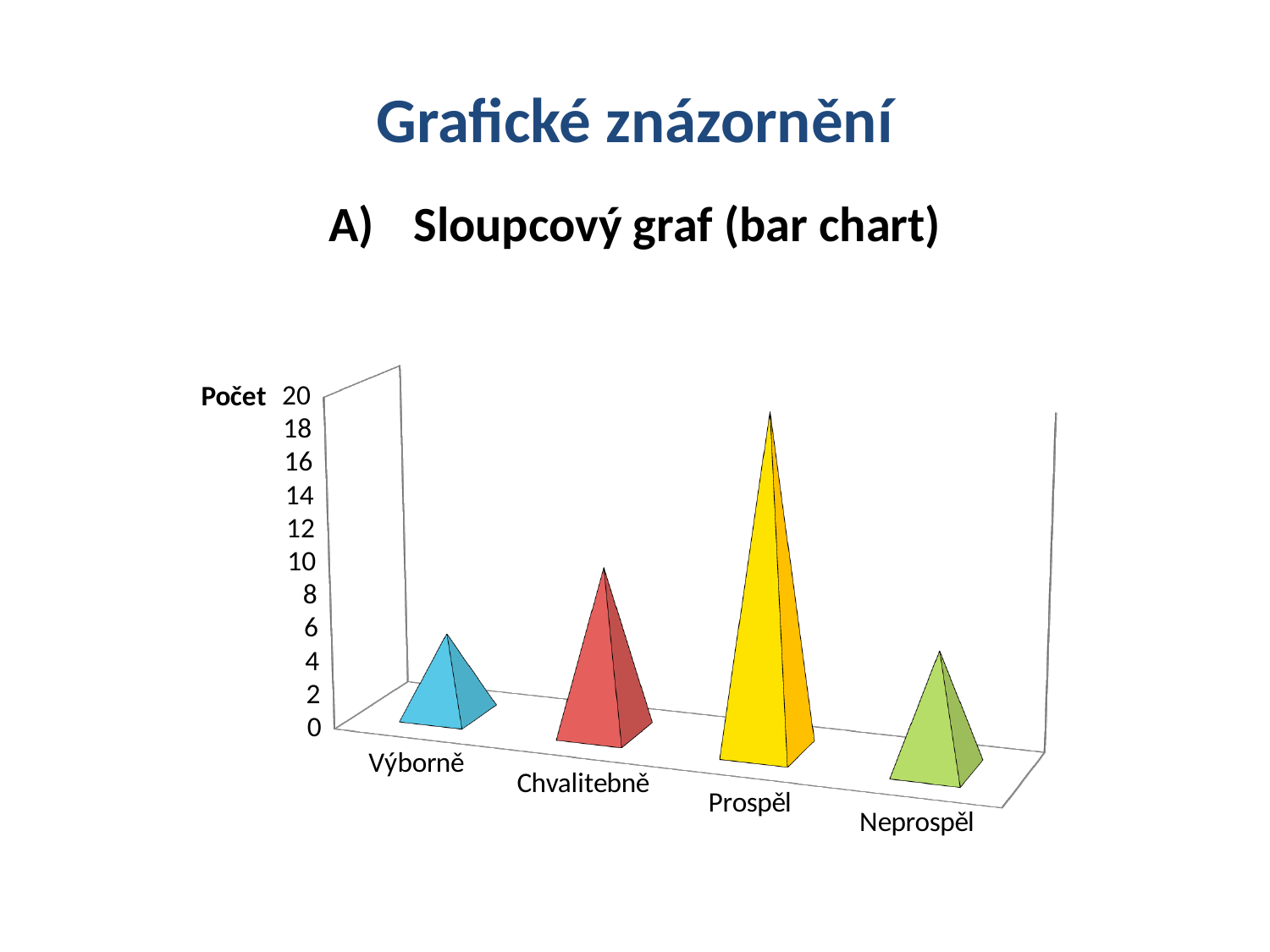
What is the highest value shown on the vertical axis of the chart? 20 What is the label of the vertical axis of the chart? Počet Is the value for Výborně greater or less than 2? greater Which is larger, the value for Chvalitebně or the value for Výborně? Chvalitebně Is the value for Výborně greater or less than 10? less Which is larger, the value for Prospěl or the value for Chvalitebně? Prospěl Is the value for Prospěl greater or less than 10? greater Which category has the highest value in the chart? Prospěl What colour is the bar for Prospěl? yellow How many categories are shown on the x axis of the chart? 4 What kind of chart is shown on the slide? bar chart